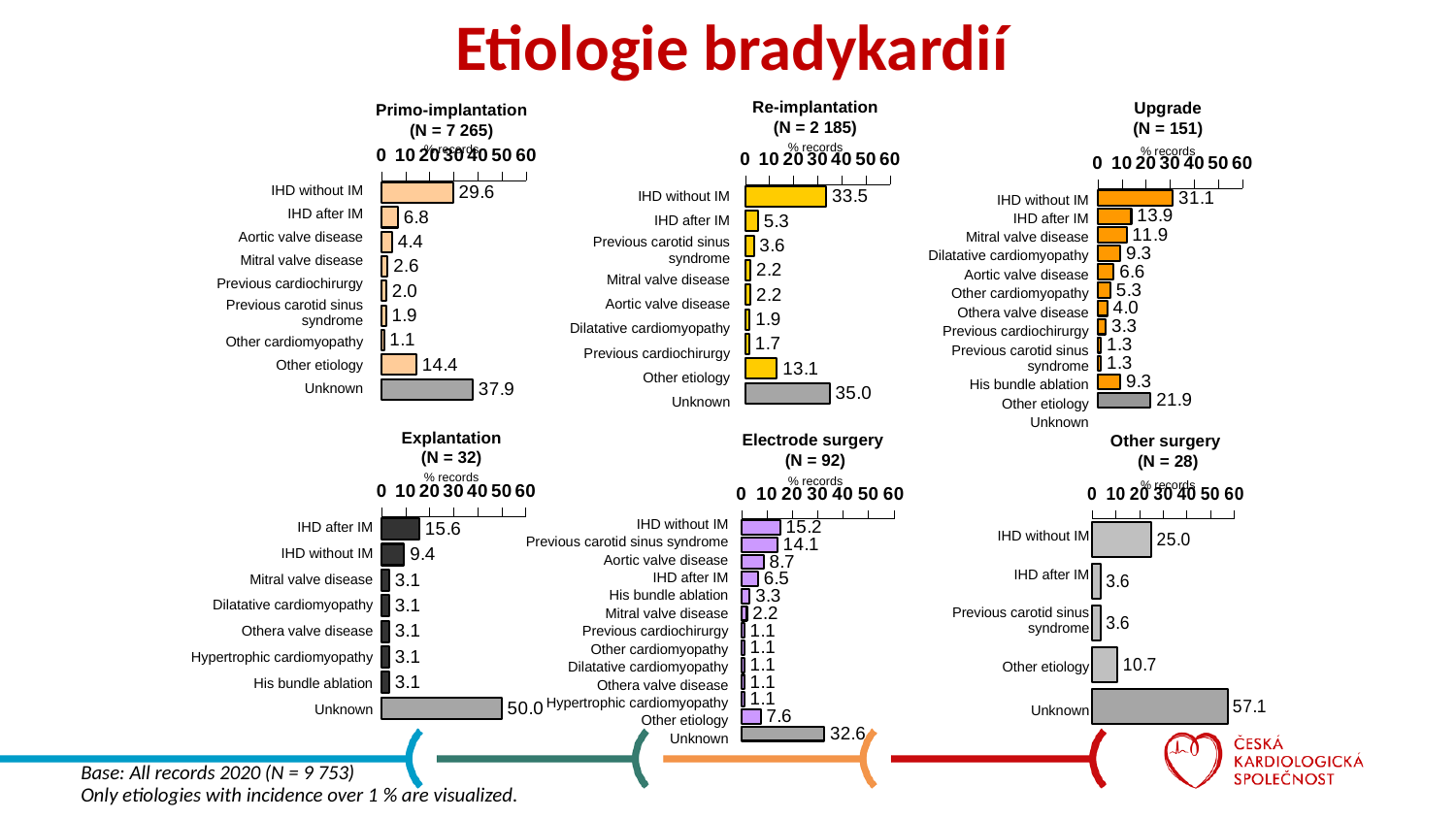
In the Explantation chart, which is larger, IHD after IM or IHD without IM? IHD after IM In the Primo-implantation chart, what is the value for Unknown? 37.9 In the Other surgery chart, what is the value for Unknown? 57.1 In the Re-implantation chart, what is the difference between Unknown and IHD without IM? 1.5 In the Upgrade chart, what is the value for IHD without IM? 31.1 In the Primo-implantation chart, what is the value for IHD without IM? 29.6 What type of chart is the Primo-implantation chart? Bar chart In the Other surgery chart, is the value for Unknown greater or less than 50? greater In the Re-implantation chart, which category has the highest value? Unknown In the Explantation chart, what is the value for Unknown? 50.0 In the Electrode surgery chart, what is the value for Previous carotid sinus syndrome? 14.1 How many categories are shown in the Other surgery chart? 5